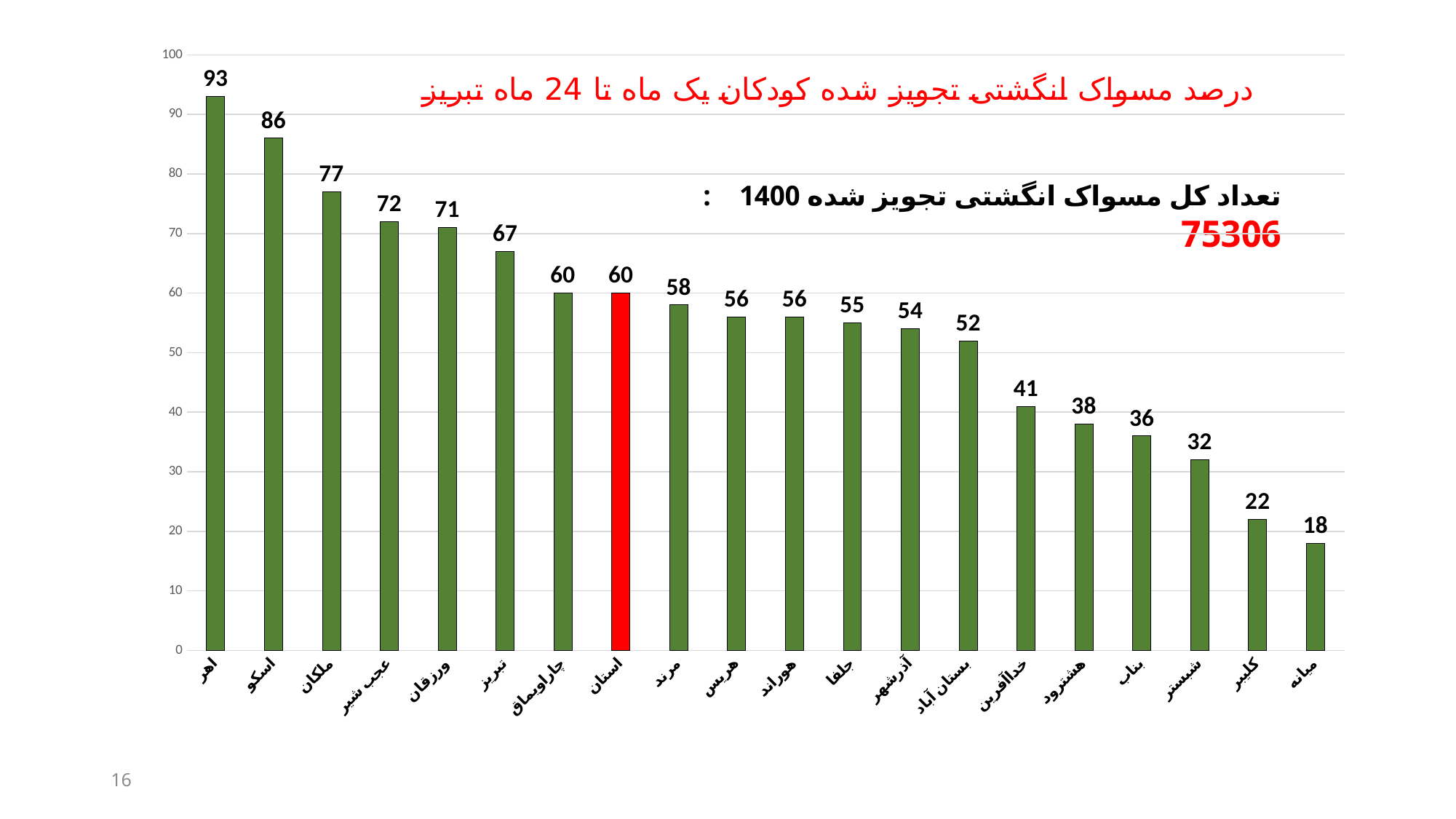
What is the value for میانه? 18 Which bar is coloured red instead of green? استان What is the difference between the values for اسکو and ملکان? 9 What is the value for اهر? 93 Do the values rise or fall from left to right along the x axis? fall How many bars are shown in the chart? 20 Which is larger, the value for تبریز or the value for مرند? تبریز Is the value for خداآفرین greater or less than 50? less What is the value for the red bar labelled استان? 60 Which category has the lowest value? میانه What kind of chart is shown on the slide? bar chart Which category has the highest value? اهر